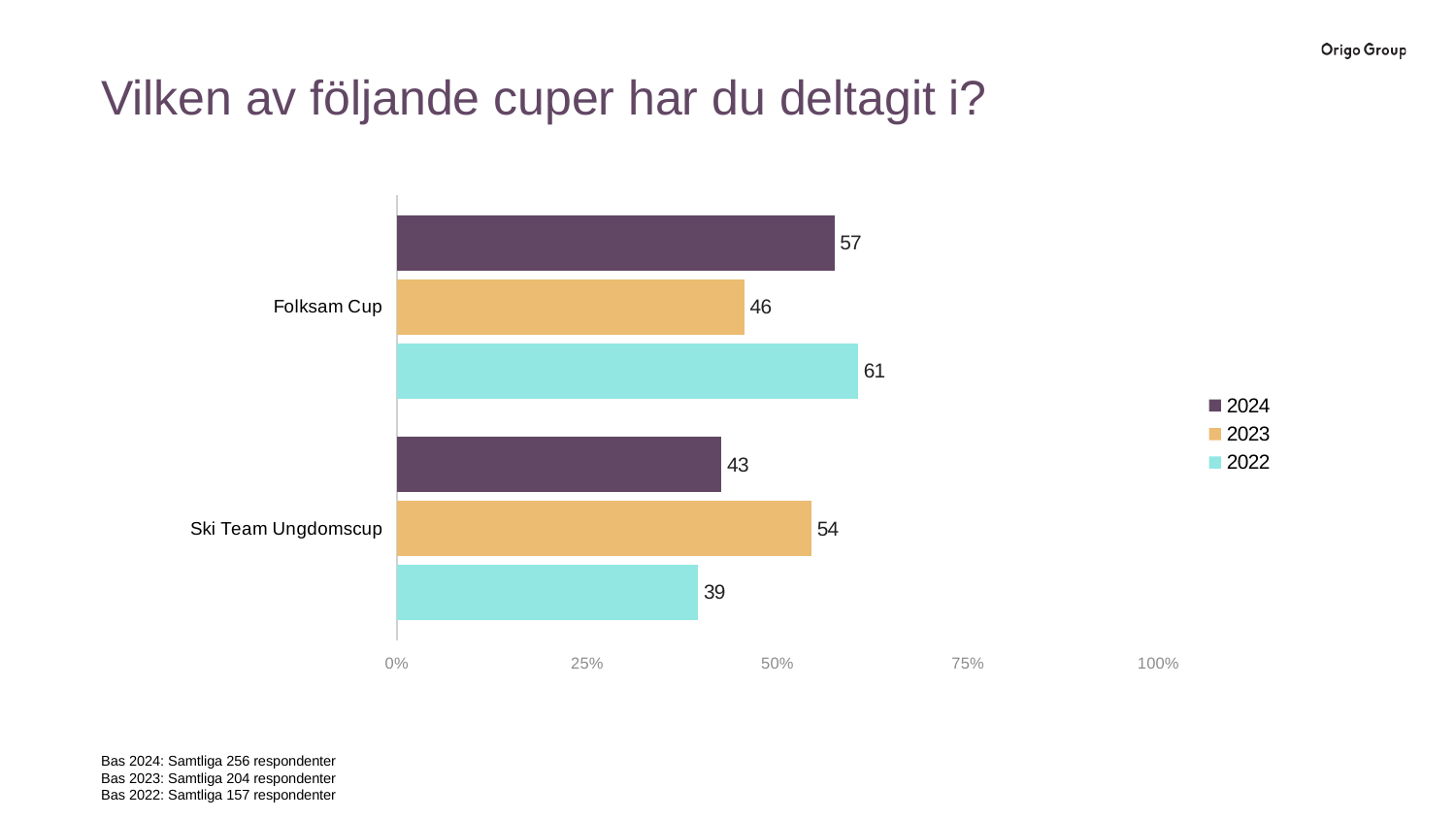
What is the difference between the 2022 and 2023 values for Folksam Cup? 15 Is the 2022 value for Ski Team Ungdomscup greater or less than 50%? less Which year has the lowest value for Ski Team Ungdomscup? 2022 What is the value for Folksam Cup in 2023? 46 Which year has the highest value for Folksam Cup? 2022 What is the difference between the 2023 and 2024 values for Ski Team Ungdomscup? 11 What is the value for Folksam Cup in 2024? 57 How many categories (cups) are shown on the chart? 2 How many series does the legend list? 3 What kind of chart is shown on the slide? Bar chart Which is larger: the 2024 value for Folksam Cup or the 2024 value for Ski Team Ungdomscup? Folksam Cup What is the value for Ski Team Ungdomscup in 2022? 39